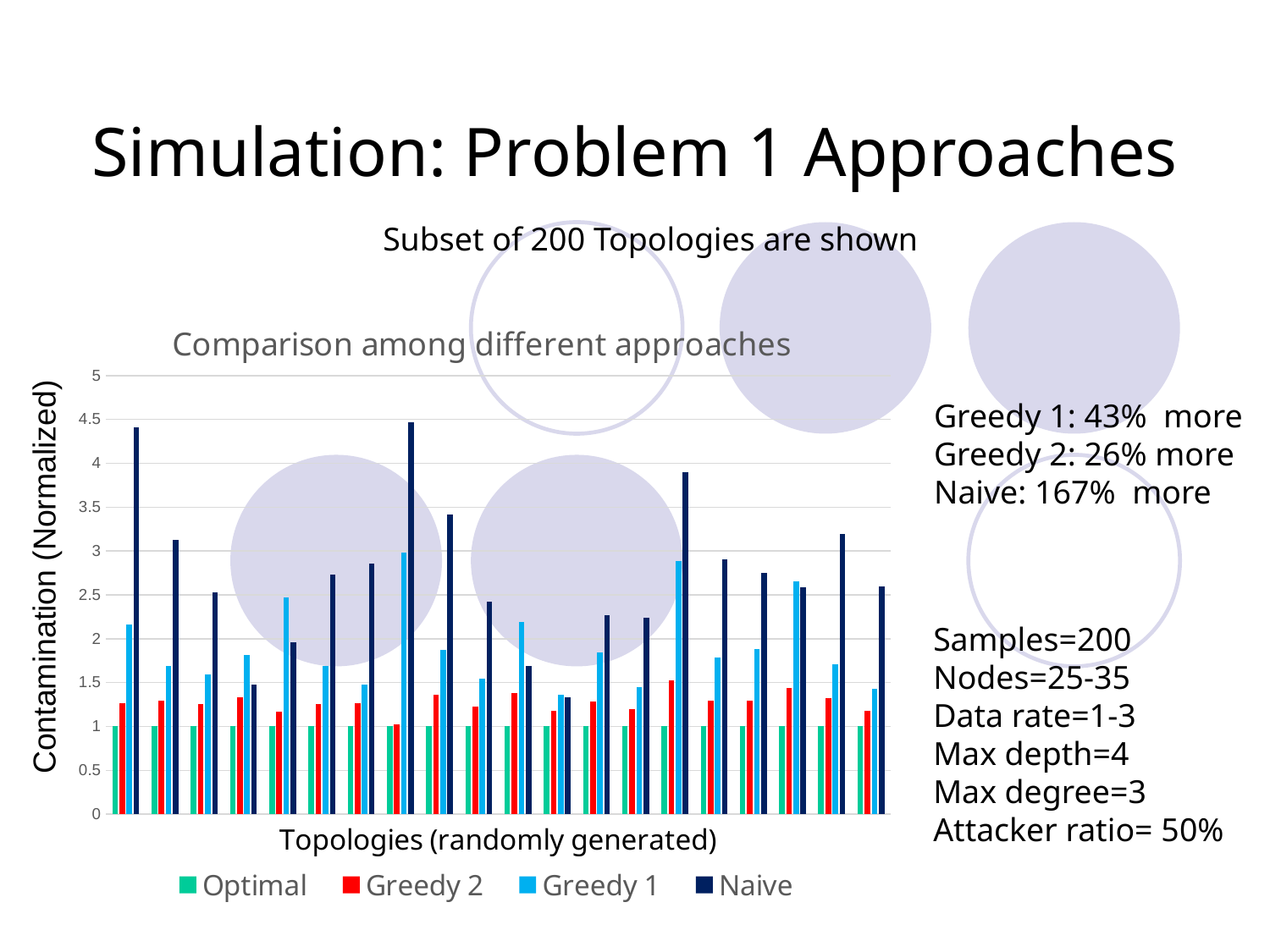
How many groups of bars (topologies) are plotted in the chart? 20 Which series has the tallest bar in the first (leftmost) group of bars? Naive In the first (leftmost) group of bars, is the Greedy 1 value greater or less than 2.5? less In the first (leftmost) group of bars, which is larger, Greedy 1 or Greedy 2? Greedy 1 In the first (leftmost) group of bars, is the Naive value greater or less than 4? greater What is the title of the chart? Comparison among different approaches Which series has the shortest bar in the first (leftmost) group of bars? Optimal In the first (leftmost) group of bars, is the Optimal value greater or less than 1.5? less What is the label of the vertical axis of the chart? Contamination (Normalized) What kind of chart is shown on the slide? bar chart How many series does the legend of the chart list? 4